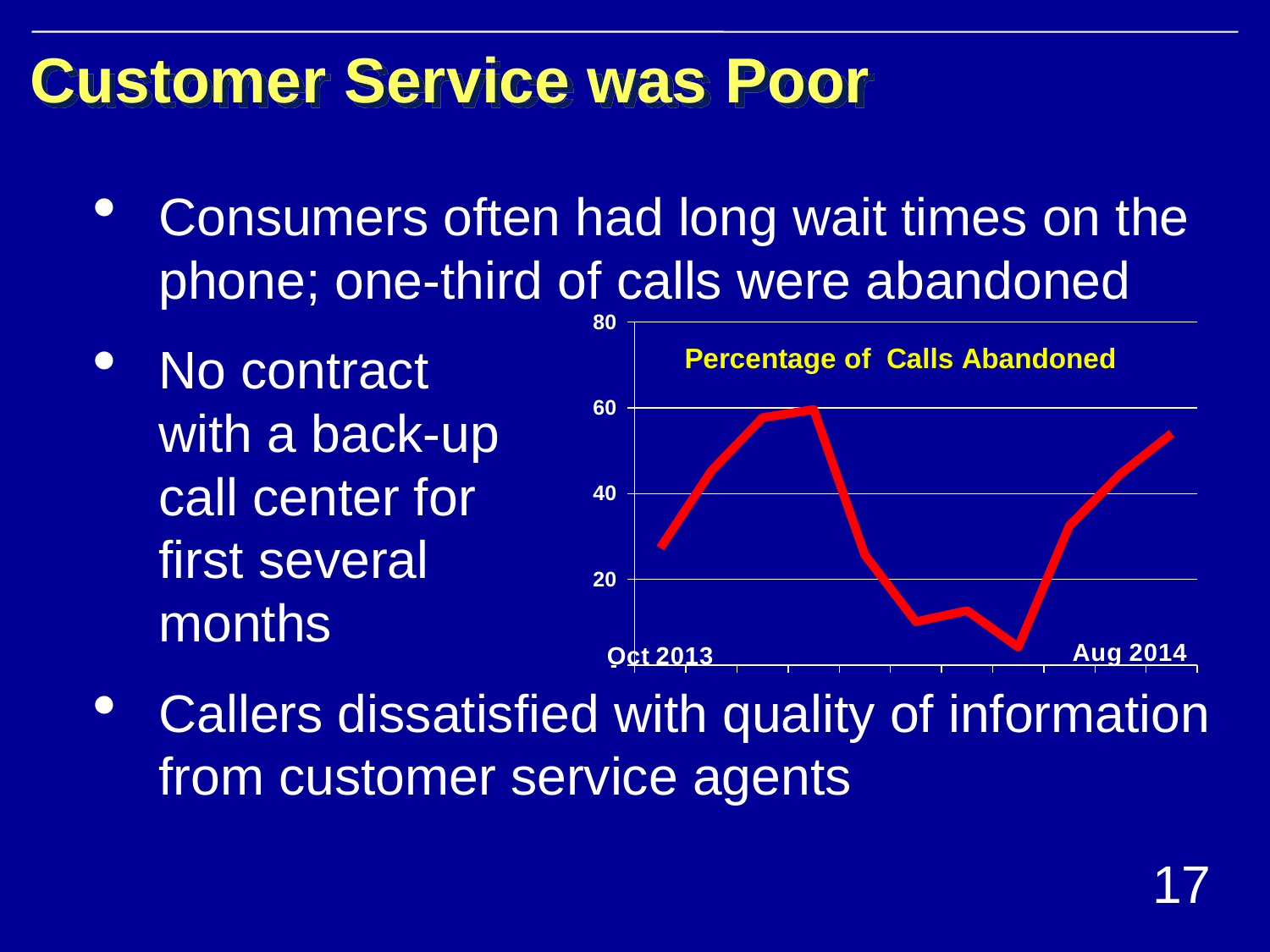
Is the value for Oct 2013 greater or less than 40? less Is the highest value on the line greater or less than 40? greater What is the highest value shown on the y axis? 80 What is the title of the chart? Percentage of Calls Abandoned Is the value for Oct 2013 greater or less than 20? greater Which is larger, the value for Oct 2013 or the value for Aug 2014? Aug 2014 What colour is the line plotted in the chart? red Does the line rise or fall between Oct 2013 and its peak? rise What kind of chart is shown on the slide? line chart Does the line rise or fall over the last few points leading up to Aug 2014? rise